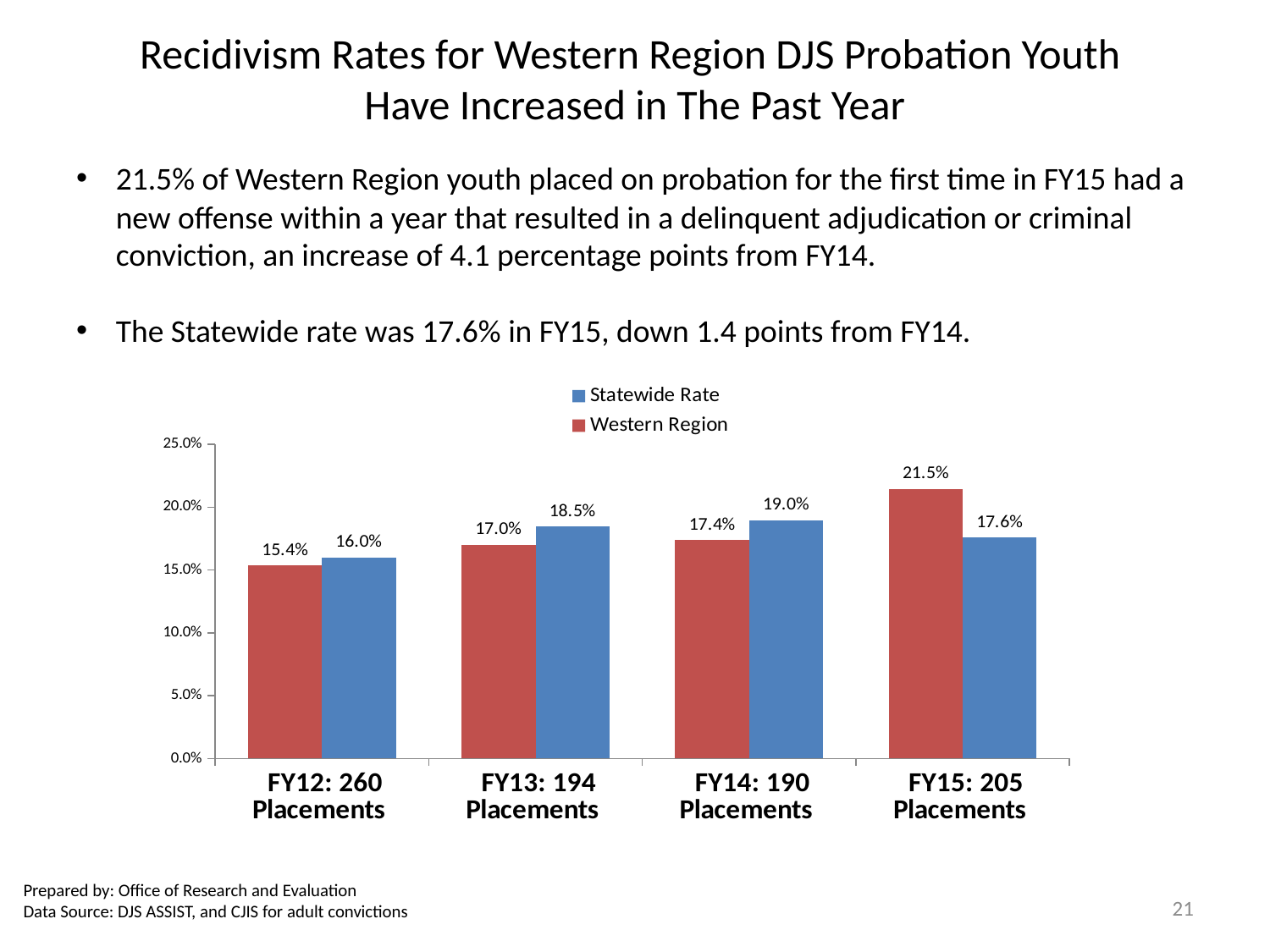
How many series does the legend list? 2 What is the Western Region recidivism rate for FY15: 205 Placements? 21.5% How many fiscal year categories are shown on the x axis? 4 What is the difference between the Western Region rate and the Statewide Rate for FY15: 205 Placements? 3.9 percentage points What is the Western Region rate for FY12: 260 Placements? 15.4% What kind of chart is shown on the slide? Bar chart Is the Statewide Rate for FY15: 205 Placements greater or less than 20.0%? less For FY14: 190 Placements, which is larger, the Statewide Rate or the Western Region rate? Statewide Rate In which fiscal year category is the Western Region rate highest? FY15: 205 Placements What is the Statewide Rate for FY13: 194 Placements? 18.5% In which fiscal year category is the Statewide Rate lowest? FY12: 260 Placements By how many percentage points did the Western Region rate change from FY14: 190 Placements to FY15: 205 Placements? 4.1 percentage points